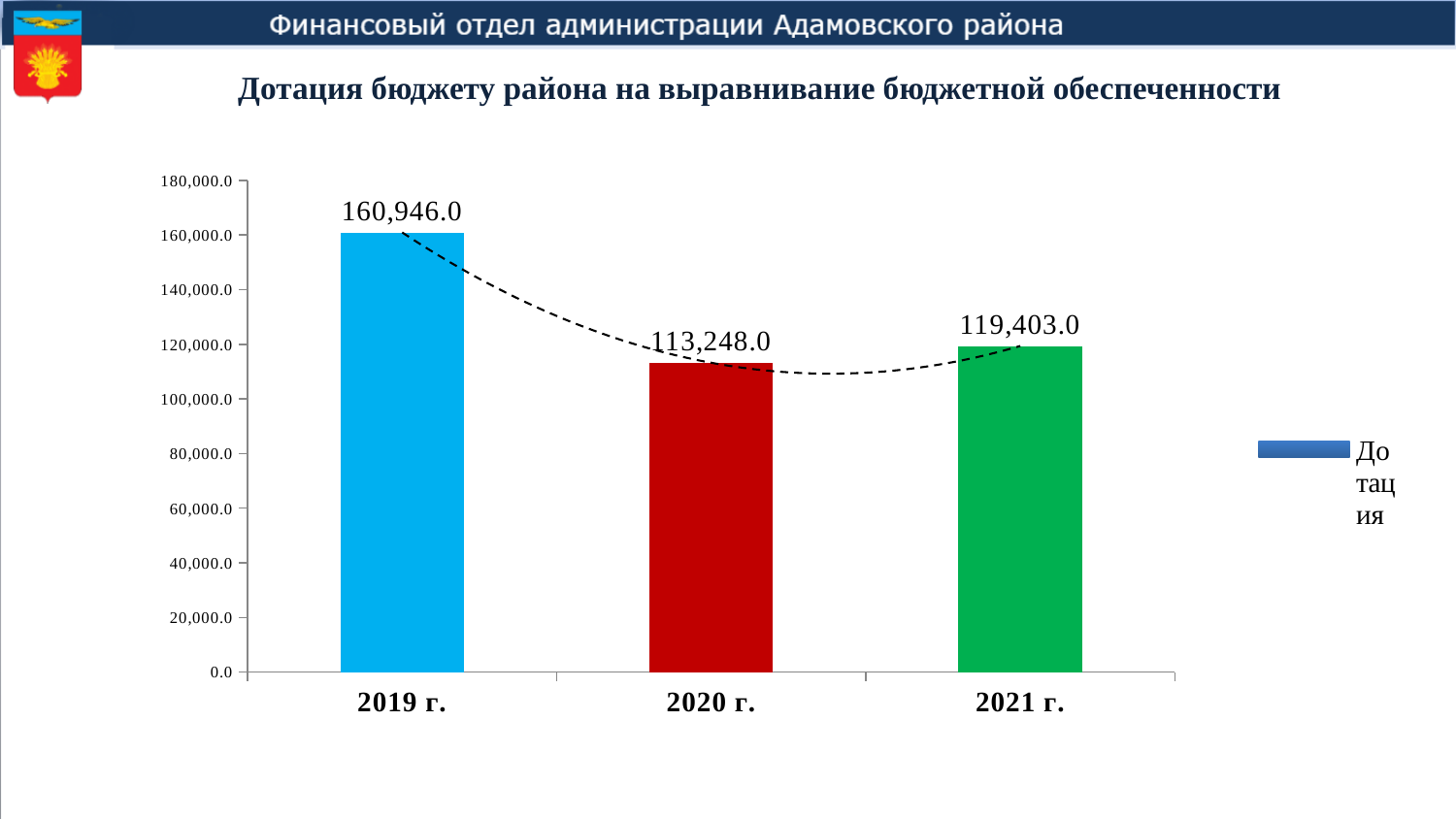
How many years are shown on the x axis? 3 What is the title of the chart? Дотация бюджету района на выравнивание бюджетной обеспеченности Is the value for 2019 г. greater or less than 140,000.0? greater What is the value for 2020 г.? 113,248.0 What is the value for 2021 г.? 119,403.0 Which is larger, the value for 2021 г. or the value for 2020 г.? 2021 г. What kind of chart is shown on the slide? bar chart What is the difference between the values for 2019 г. and 2020 г.? 47,698.0 What is the value for 2019 г.? 160,946.0 What is the difference between the values for 2021 г. and 2020 г.? 6,155.0 Which year has the highest value? 2019 г. Which year has the lowest value? 2020 г.